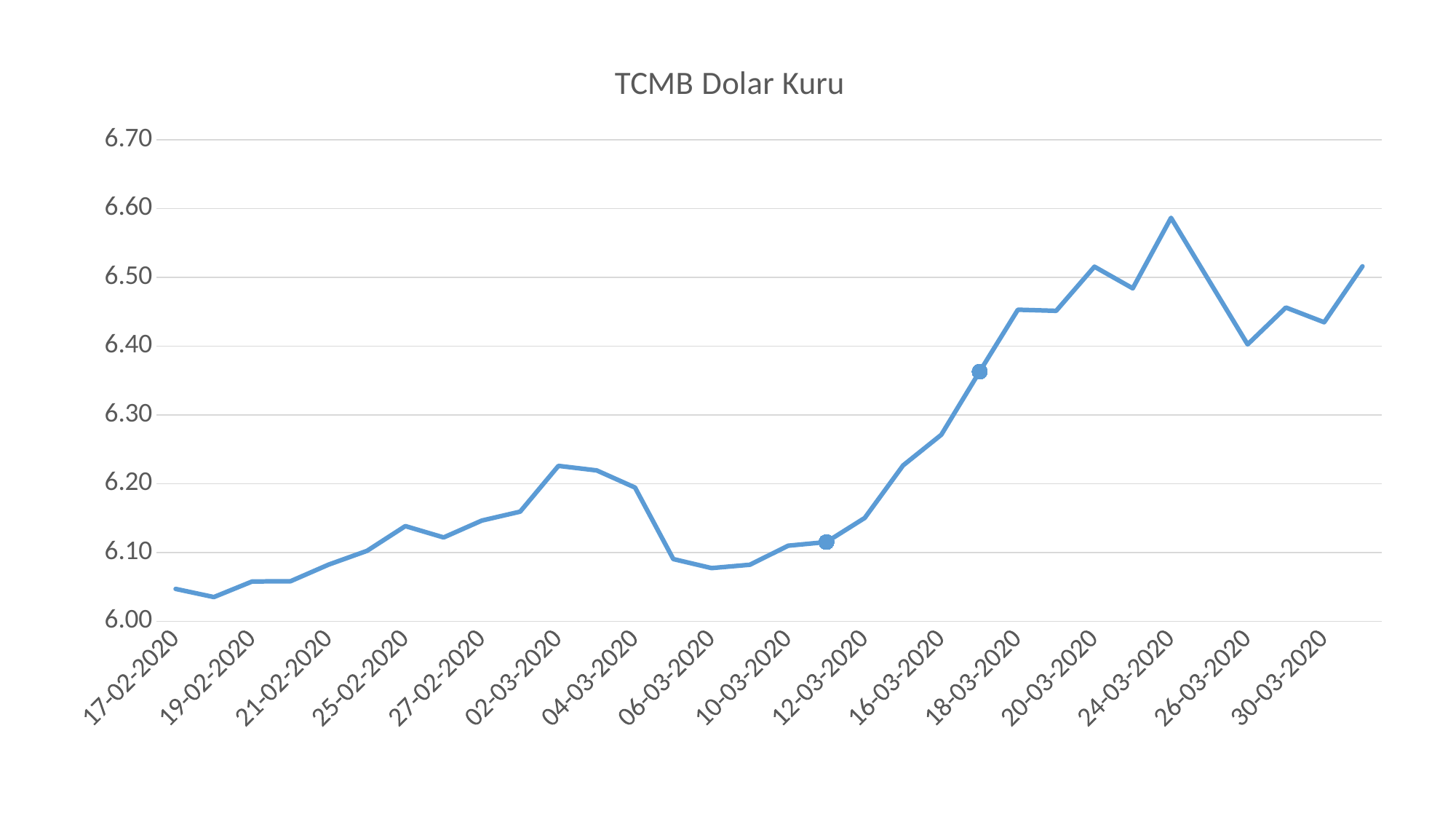
Overall, do the values rise or fall from 17-02-2020 to the end of the series? rise Is the value for 02-03-2020 greater or less than 6.30? less Is the value for 18-03-2020 greater or less than 6.30? greater Is the value for 17-02-2020 greater or less than 6.10? less On which date does the line reach its highest value? 24-03-2020 What kind of chart is shown on the slide? line chart What is the highest value shown on the vertical axis? 6.70 What is the title of the chart? TCMB Dolar Kuru Which date has the larger value, 17-02-2020 or 24-03-2020? 24-03-2020